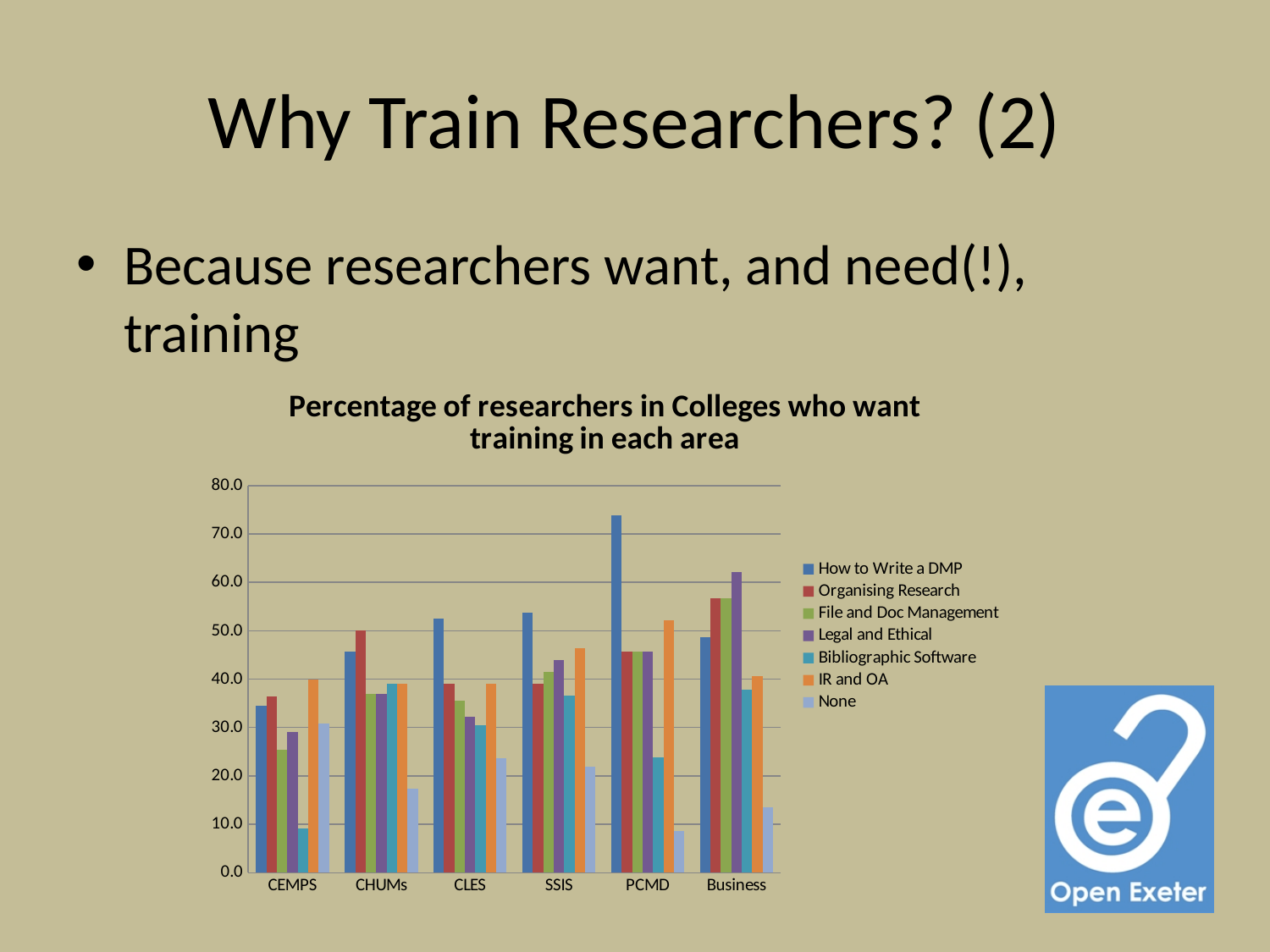
How many colleges are shown along the x axis of the chart? 6 Is the value for 'Bibliographic Software' at CEMPS greater or less than 20.0? less Is the value for 'Legal and Ethical' at Business greater or less than 60.0? greater Is the value for 'How to Write a DMP' at CLES greater or less than 50.0? greater How many series does the chart's legend list? 7 Which college has the highest value for 'How to Write a DMP'? PCMD What is the title of the chart? Percentage of researchers in Colleges who want training in each area What kind of chart is shown on the slide? Bar chart At Business, which is larger: 'Legal and Ethical' or 'How to Write a DMP'? Legal and Ethical Which college has the lowest value for 'None'? PCMD Which college has the larger value for 'Organising Research': CHUMs or CEMPS? CHUMs